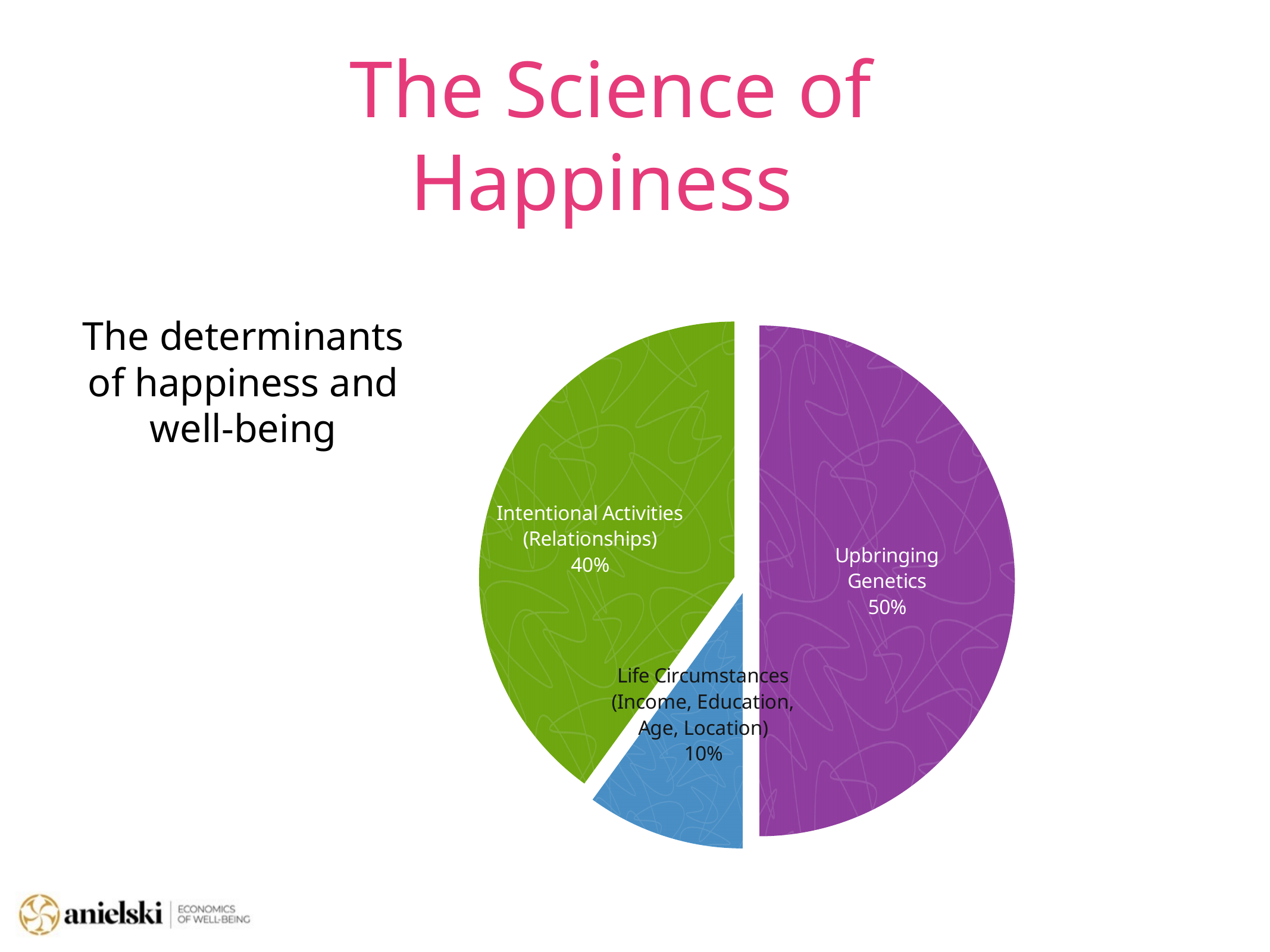
Which is larger: the Intentional Activities (Relationships) slice or the Life Circumstances slice? Intentional Activities (Relationships) Which slice of the pie is the largest? Upbringing Genetics Which slice of the pie is the smallest? Life Circumstances (Income, Education, Age, Location) What is the difference in percentage points between the Upbringing Genetics slice and the Intentional Activities (Relationships) slice? 10 percentage points What colour is the Upbringing Genetics slice? purple What share of the pie is labelled Upbringing Genetics? 50% What share of the pie is labelled Life Circumstances (Income, Education, Age, Location)? 10% How many slices does the pie chart have? 3 What kind of chart is shown on the slide? pie chart What share of the pie is labelled Intentional Activities (Relationships)? 40% What is the difference in percentage points between the Intentional Activities (Relationships) slice and the Life Circumstances slice? 30 percentage points What colour is the Life Circumstances slice? blue